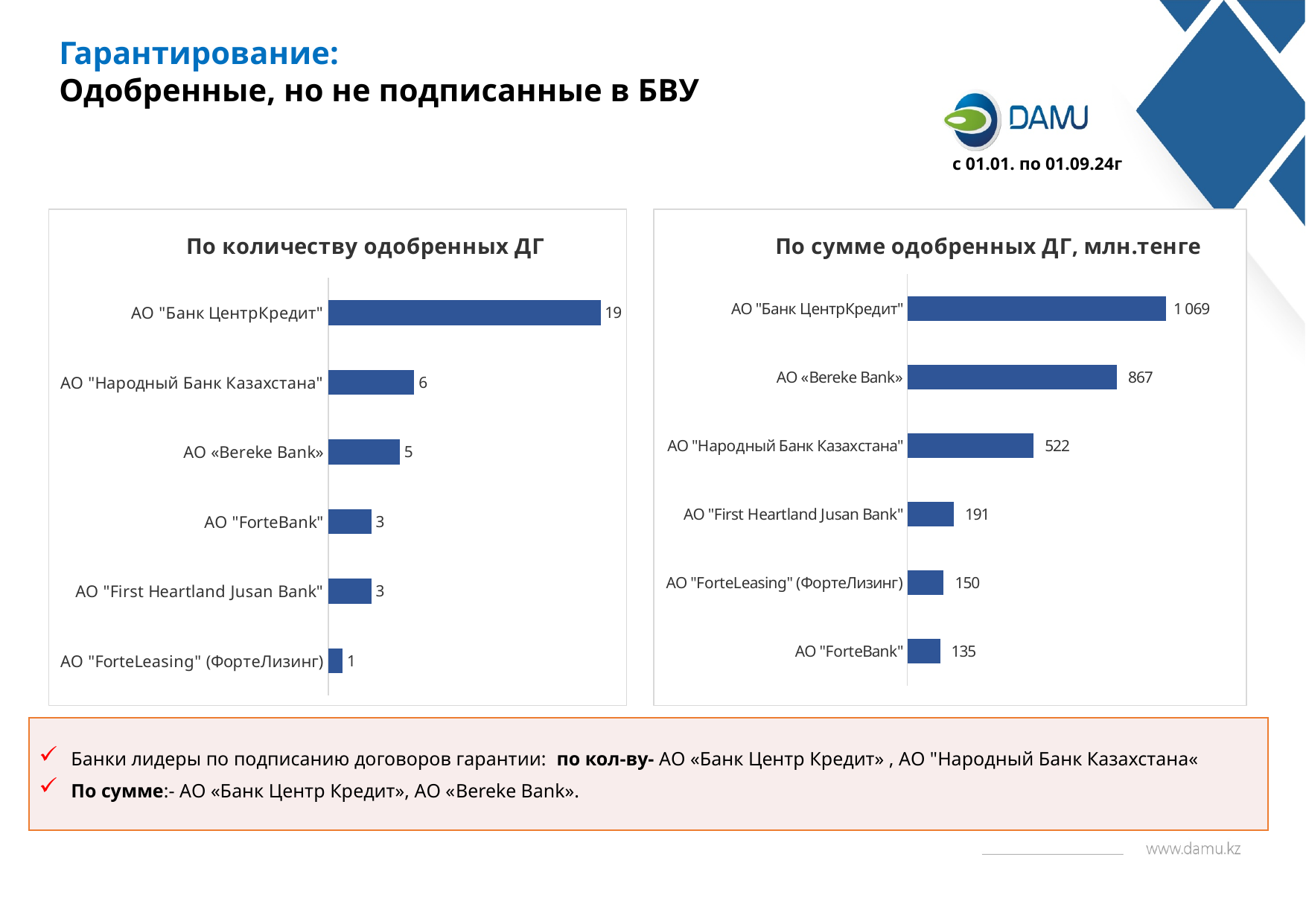
In the chart "По сумме одобренных ДГ, млн.тенге", which is larger: АО "ForteLeasing" (ФортеЛизинг) or АО "ForteBank"? АО "ForteLeasing" (ФортеЛизинг) What type of chart is the left chart "По количеству одобренных ДГ"? Bar chart In the chart "По сумме одобренных ДГ, млн.тенге", what is the value for АО «Bereke Bank»? 867 In the chart "По количеству одобренных ДГ", what is the value for АО "Банк ЦентрКредит"? 19 In the chart "По сумме одобренных ДГ, млн.тенге", which bank has the lowest value? АО "ForteBank" In the chart "По сумме одобренных ДГ, млн.тенге", which bank has the highest value? АО "Банк ЦентрКредит" In the chart "По количеству одобренных ДГ", what is the difference between АО "Банк ЦентрКредит" and АО "Народный Банк Казахстана"? 13 In the chart "По сумме одобренных ДГ, млн.тенге", what is the value for АО "First Heartland Jusan Bank"? 191 In the chart "По сумме одобренных ДГ, млн.тенге", what is the difference between АО «Bereke Bank» and АО "Народный Банк Казахстана"? 345 In the chart "По количеству одобренных ДГ", what is the value for АО «Bereke Bank»? 5 In the chart "По количеству одобренных ДГ", how many banks are shown? 6 In the chart "По количеству одобренных ДГ", which bank has the lowest value? АО "ForteLeasing" (ФортеЛизинг)